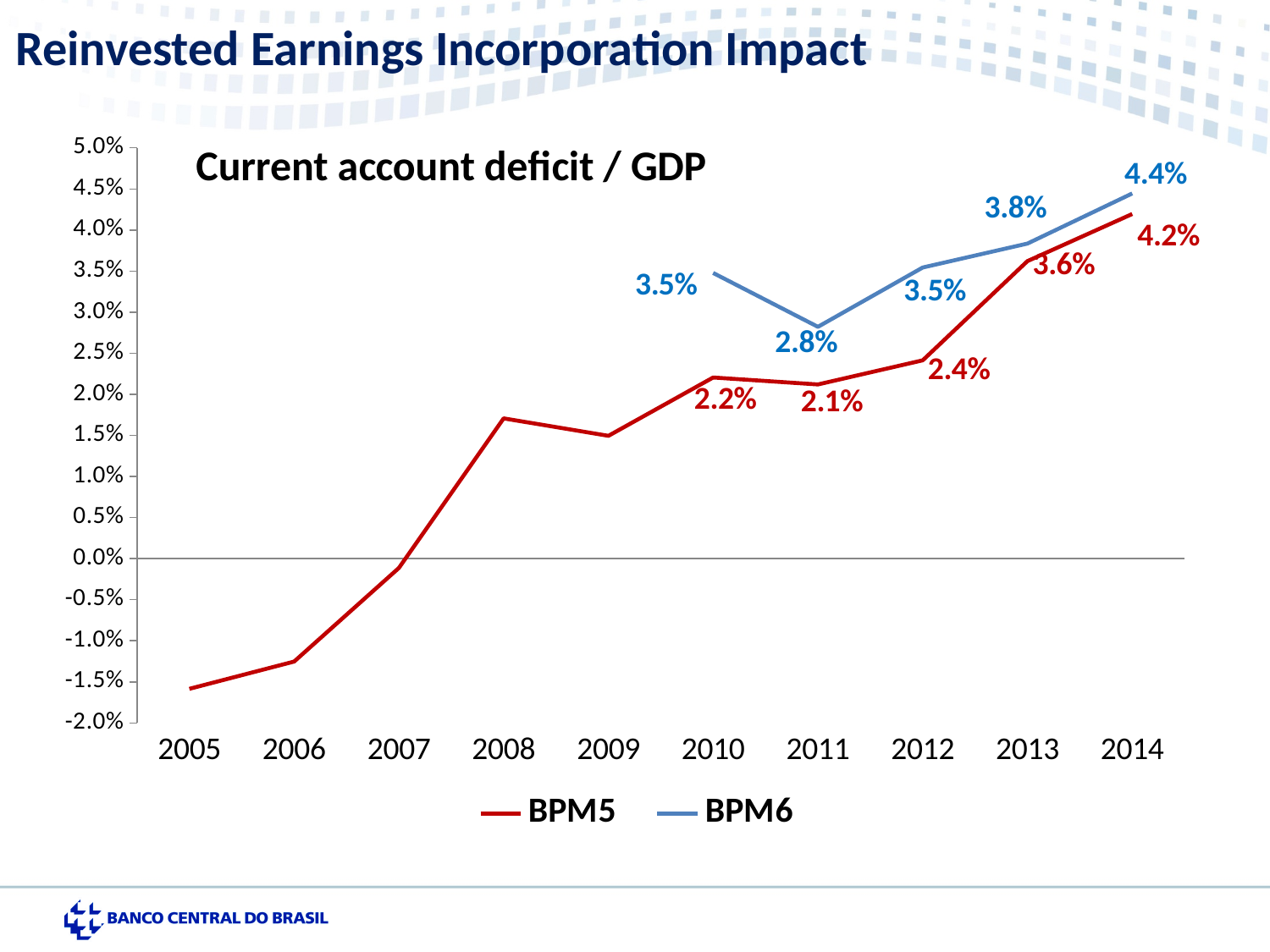
Is the BPM5 value for 2008 greater or less than 1.5%? greater What kind of chart is shown on the slide? Line chart Is the BPM5 value for 2005 greater or less than -1.0%? less Which series has the higher value in 2010, BPM5 or BPM6? BPM6 What is the BPM5 value for 2013? 3.6% What is the BPM6 value for 2014? 4.4% What is the title of the chart? Current account deficit / GDP What is the BPM5 value for 2011? 2.1% What is the BPM6 value for 2011? 2.8% What is the difference between the BPM6 and BPM5 values in 2012? 1.1% Does the BPM5 series generally rise or fall from 2005 to 2014? Rise How many series does the legend list? 2